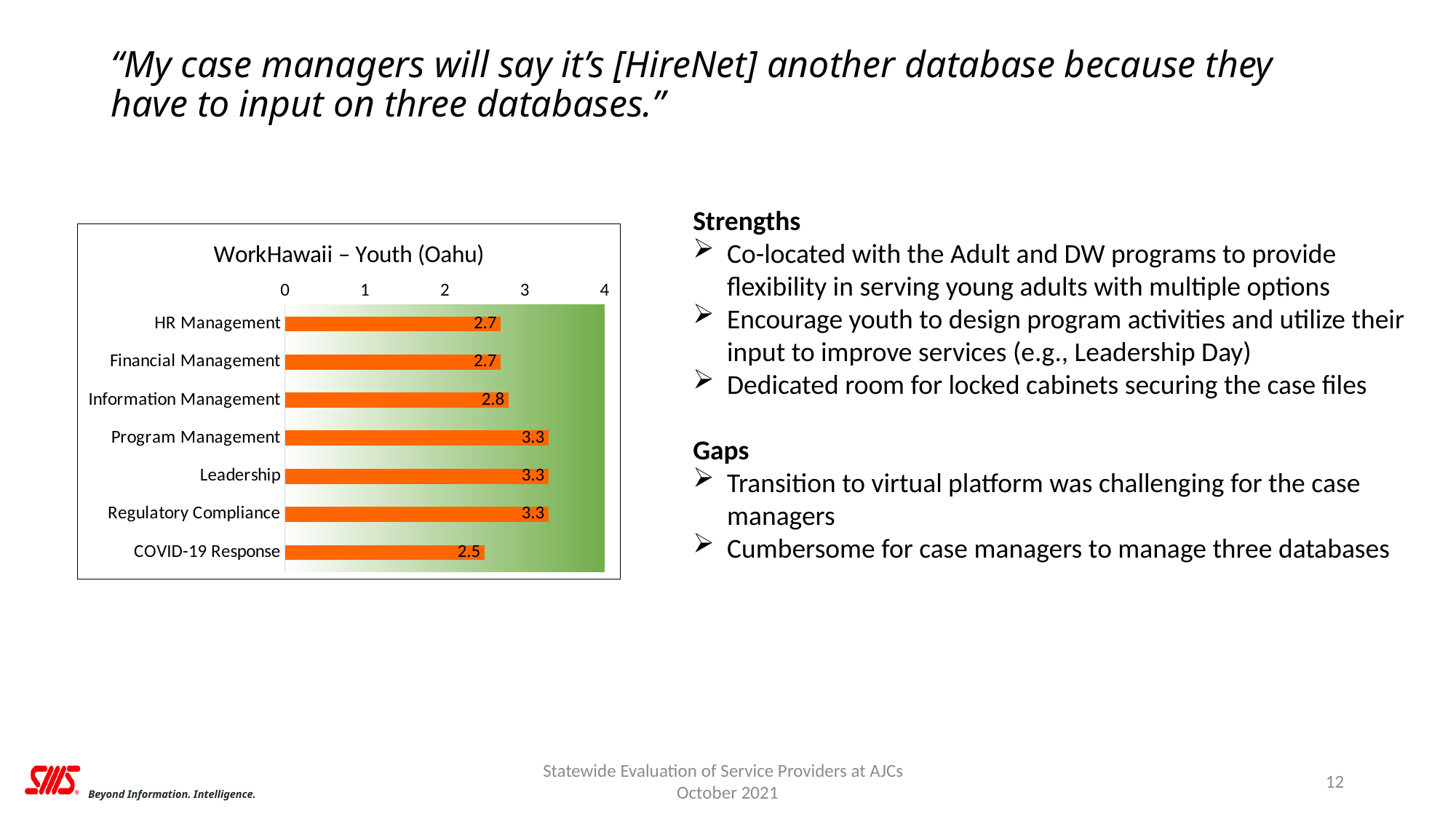
What is the title of the chart? WorkHawaii – Youth (Oahu) Which category has the lowest value? COVID-19 Response Which is larger, the value for Regulatory Compliance or the value for HR Management? Regulatory Compliance What is the difference between the values for Information Management and Financial Management? 0.1 What is the difference between the values for Program Management and COVID-19 Response? 0.8 How many categories are shown in the chart? 7 What is the value for Leadership? 3.3 What is the value for HR Management? 2.7 What kind of chart is shown on the slide? bar chart What is the value for COVID-19 Response? 2.5 Is the value for Leadership greater or less than 3? greater What is the value for Information Management? 2.8